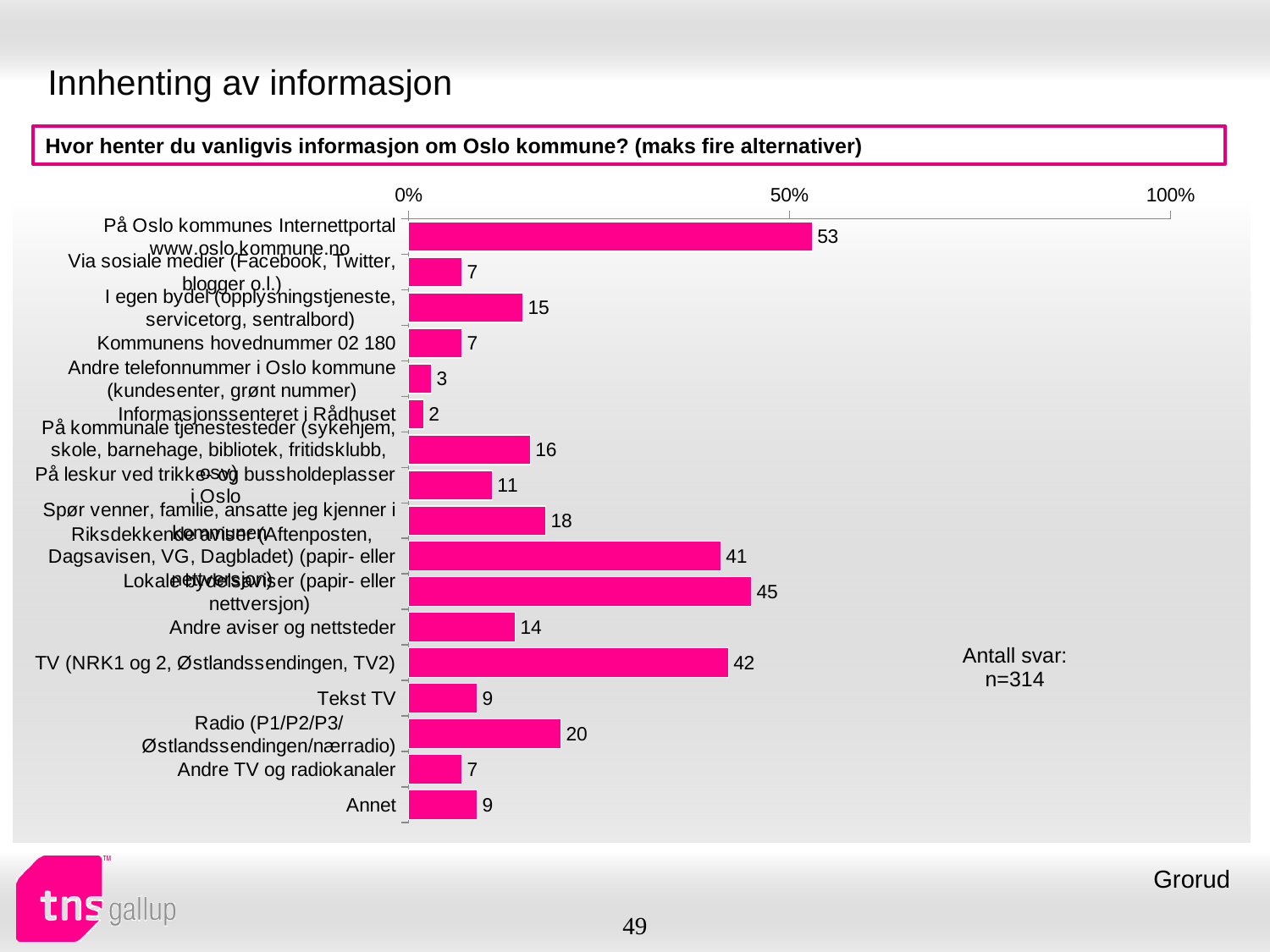
What is the value for 'Lokale bydelsaviser (papir- eller nettversjon)'? 45 Is the value for 'På Oslo kommunes Internettportal www.oslo.kommune.no' greater or less than 50%? greater Which category has the highest value? På Oslo kommunes Internettportal www.oslo.kommune.no Which category has the lowest value? Informasjonssenteret i Rådhuset What is the number of respondents (n) stated on the slide? n=314 What is the value for 'Radio (P1/P2/P3/Østlandssendingen/nærradio)'? 20 How many categories are shown in the chart? 17 What type of chart is shown on the slide? bar chart What is the difference between the values for 'TV (NRK1 og 2, Østlandssendingen, TV2)' and 'Riksdekkende aviser (Aftenposten, Dagsavisen, VG, Dagbladet) (papir- eller nettversjon)'? 1 Which is larger: the value for 'Andre aviser og nettsteder' or the value for 'Spør venner, familie, ansatte jeg kjenner i kommunen'? Spør venner, familie, ansatte jeg kjenner i kommunen What is the value for 'Tekst TV'? 9 What is the value for 'Kommunens hovednummer 02 180'? 7